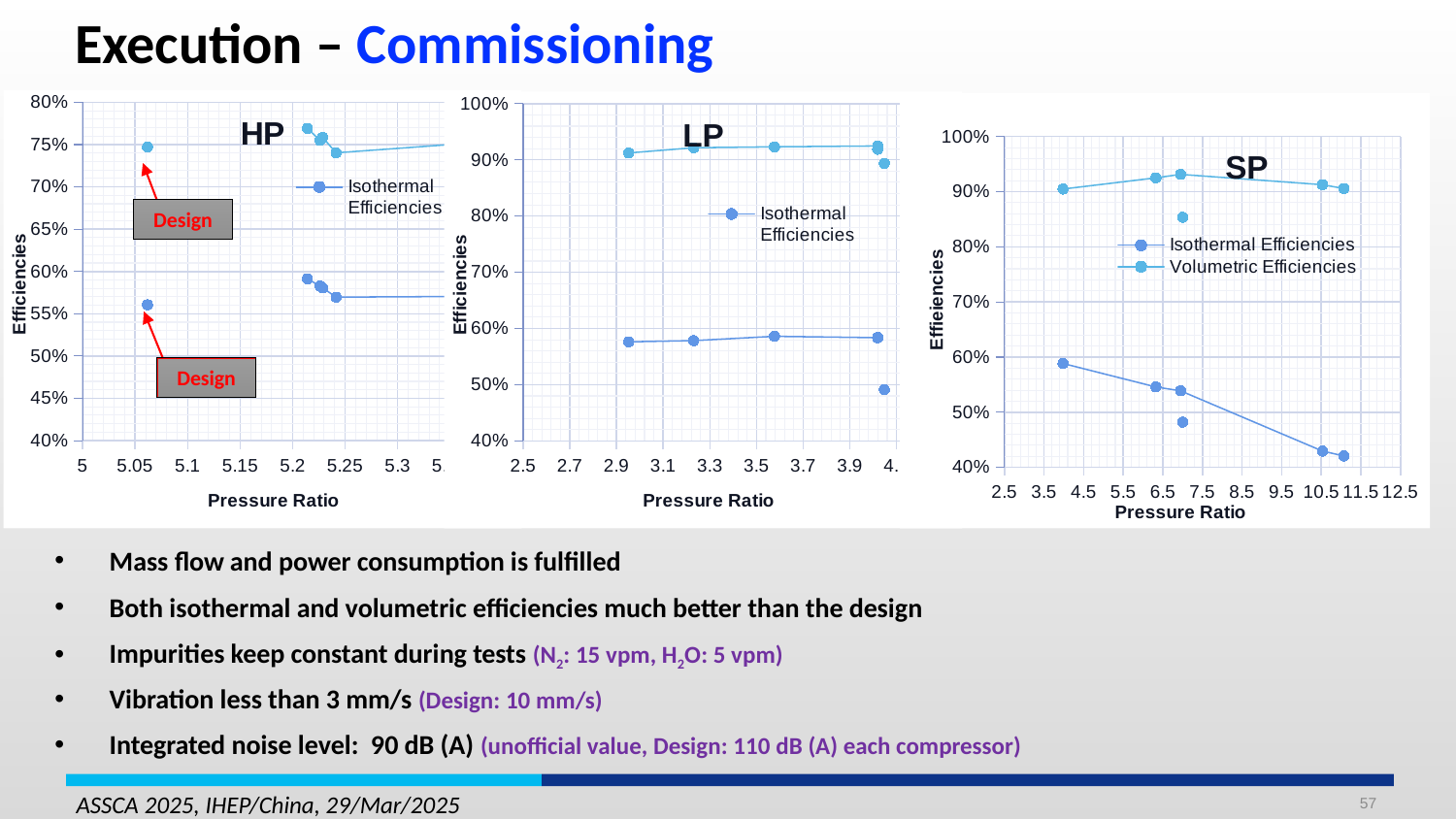
In the SP chart, is the Volumetric Efficiencies value at a pressure ratio of about 4 greater or less than 80%? greater What kind of chart is the HP chart? Scatter chart with lines In the HP chart, is the Design point for the lower series greater or less than 60%? less In the LP chart, are the upper series values (around pressure ratio 3.0 to 3.9) greater or less than 80%? greater How many series does the legend of the SP chart list? 2 In the SP chart, which series has higher values, Isothermal Efficiencies or Volumetric Efficiencies? Volumetric Efficiencies In the SP chart, do the Isothermal Efficiencies rise or fall as the pressure ratio increases? fall What is the x-axis title of the LP chart? Pressure Ratio What is the y-axis title of the SP chart? Effieiencies